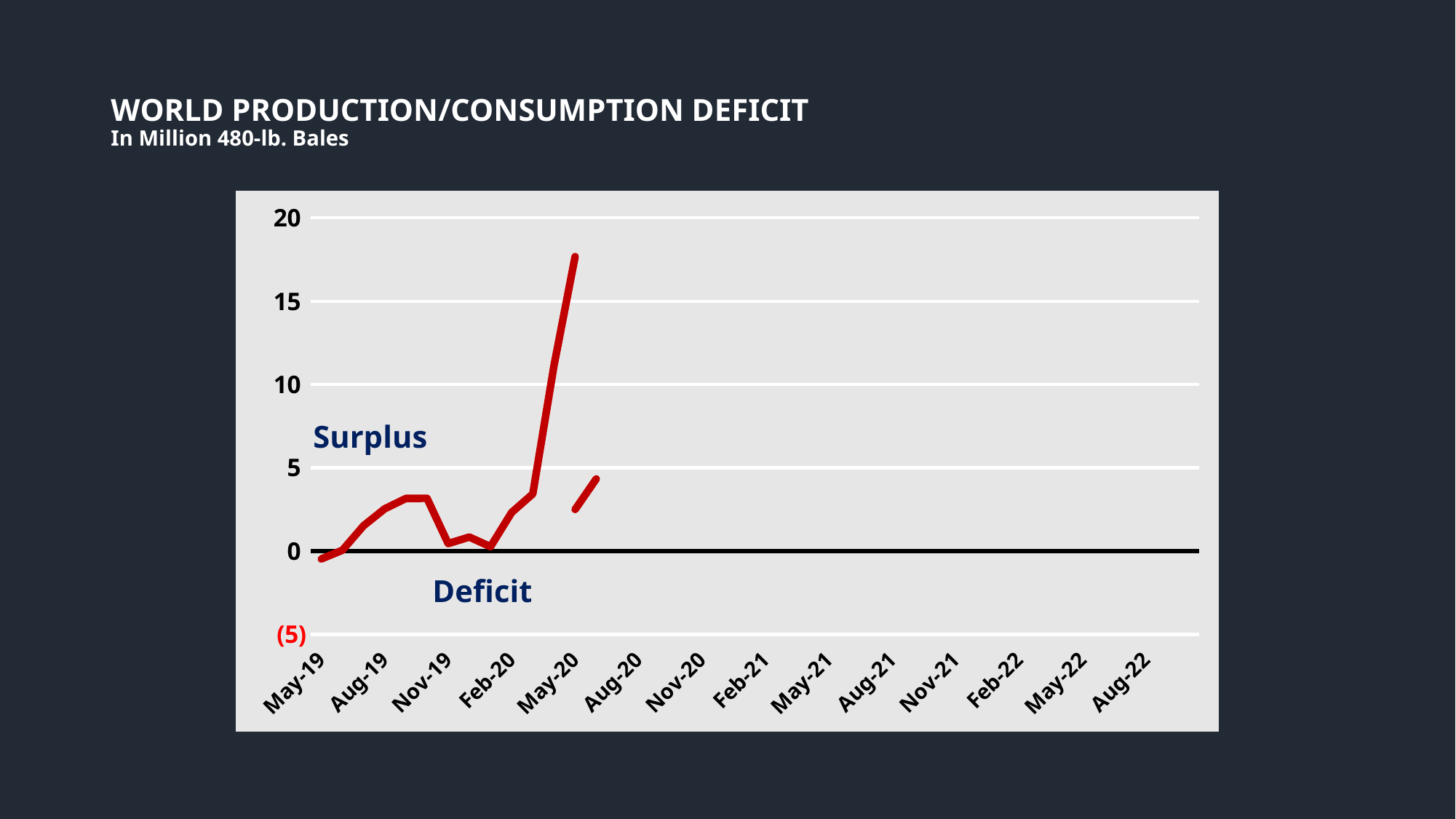
How many date labels are shown on the x axis? 14 In what units are the values on the chart expressed, according to the subtitle? Million 480-lb. Bales What kind of chart is shown on the slide? line chart What is the title of the chart? WORLD PRODUCTION/CONSUMPTION DEFICIT Is the value for Aug-19 greater or less than 5? less Is the value for Feb-20 greater or less than 5? less Is the value for Nov-19 greater or less than 5? less Does the line rise or fall between Feb-20 and May-20? rise What is the highest value shown on the y axis? 20 Which is larger, the value around May-20 or the value at Aug-19? May-20 Does the line rise or fall between Nov-19 and Feb-20? rise